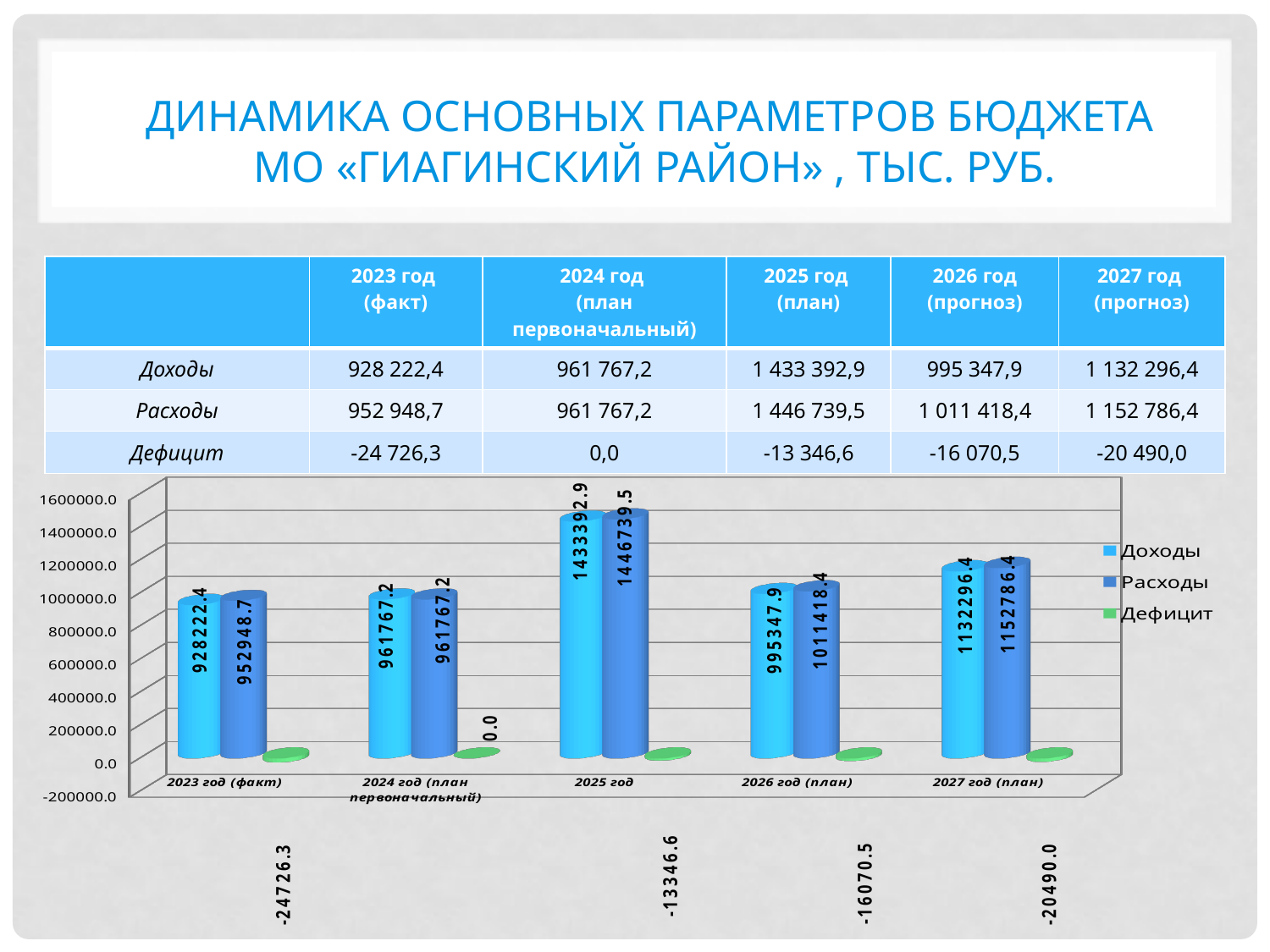
In which category is Доходы the highest? 2025 год Is the value of Доходы for 2027 год (план) greater or less than 1000000.0? greater In which category is Доходы the lowest? 2023 год (факт) Do Расходы rise or fall from 2025 год to 2026 год (план)? fall What is the value of Доходы for 2023 год (факт) in the chart? 928222.4 What is the value of Дефицит for 2027 год (план) in the chart? -20490.0 What type of chart is shown on the slide? bar chart How many year categories are shown on the x axis of the chart? 5 By how much do Расходы exceed Доходы in 2023 год (факт)? 24726.3 For 2026 год (план), which is larger: Доходы or Расходы? Расходы What is the value of Расходы for 2025 год in the chart? 1446739.5 How many series does the chart legend list? 3